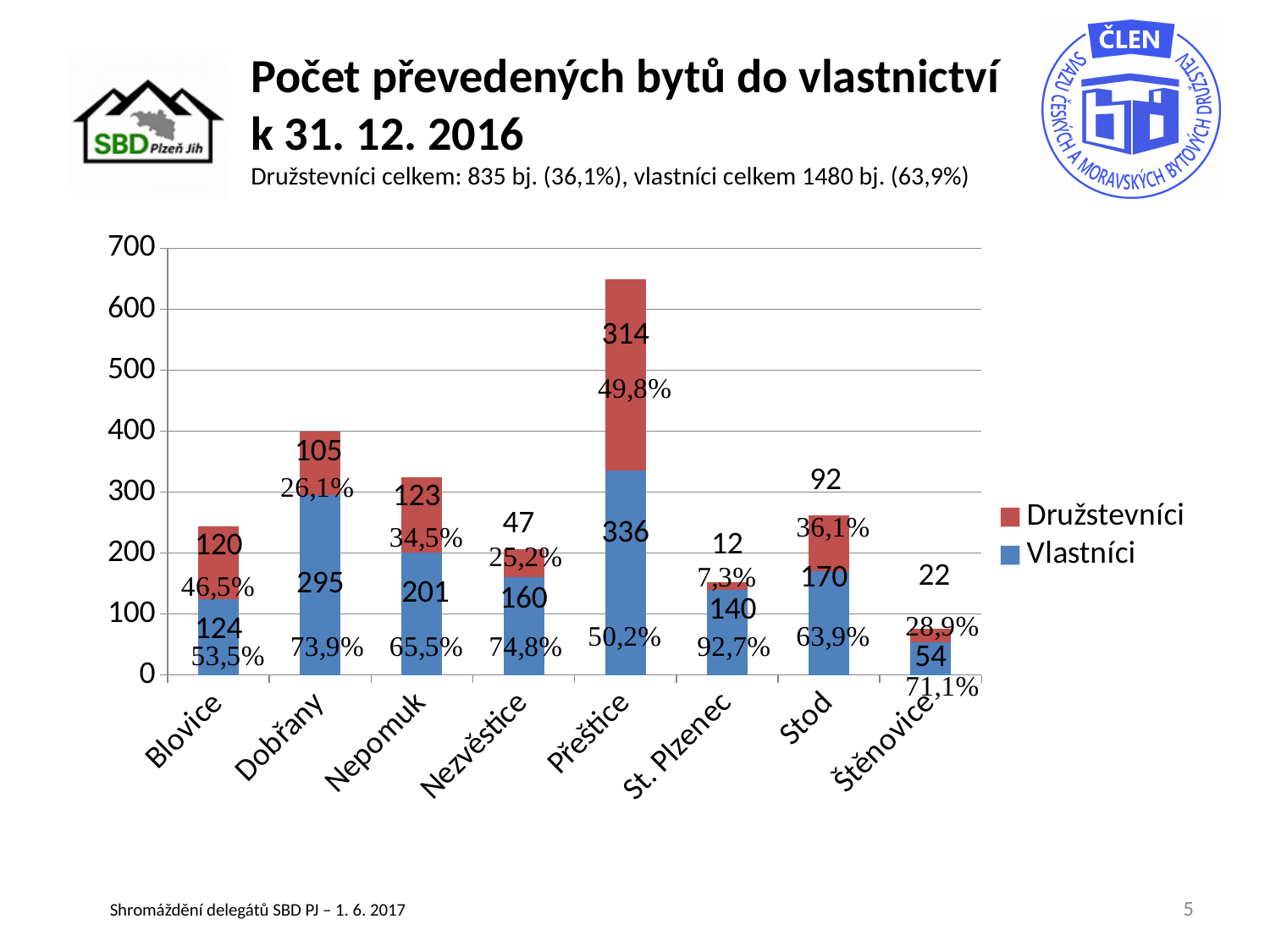
What is the difference between the Vlastníci values for Dobřany and Nepomuk? 94 What is the Družstevníci value for Dobřany? 105 What is the Vlastníci value for Přeštice? 336 What type of chart is shown on the slide? stacked bar chart Which town has the lowest Vlastníci value? Štěnovice How many categories (towns) are shown on the x axis? 8 How many series does the legend list? 2 Which series is shown in red in the legend? Družstevníci Which town has the highest Družstevníci value? Přeštice Which is larger, the Družstevníci value for Nepomuk or for Blovice? Nepomuk What is the total of the stacked bar for Stod? 262 What percentage is shown for Vlastníci in St. Plzenec? 92,7%